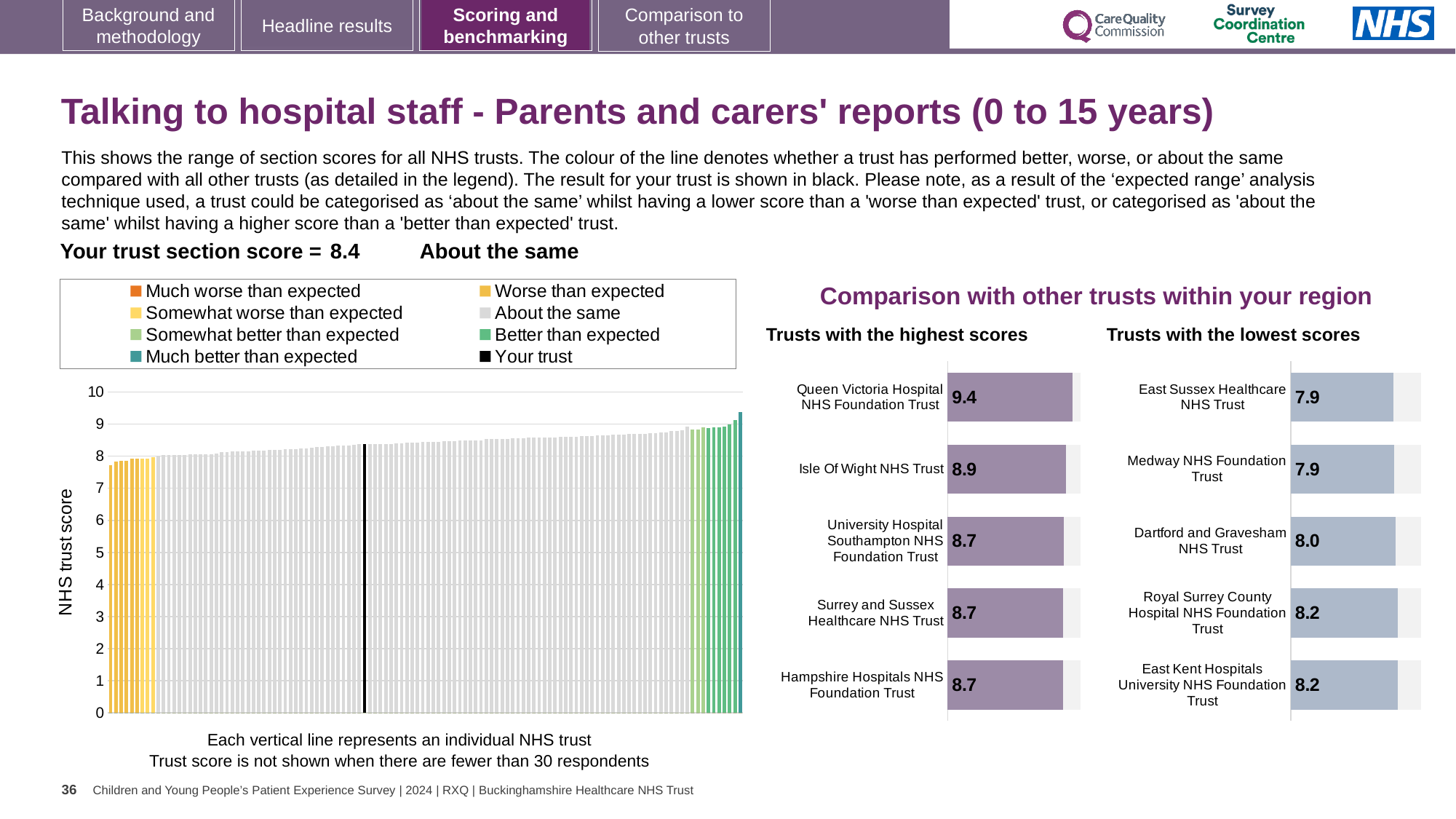
In the 'Trusts with the lowest scores' chart, what is the score for East Sussex Healthcare NHS Trust? 7.9 In the 'Trusts with the highest scores' chart, what is the score for Queen Victoria Hospital NHS Foundation Trust? 9.4 In the 'Trusts with the highest scores' chart, what is the difference between the scores of Queen Victoria Hospital NHS Foundation Trust and Isle Of Wight NHS Trust? 0.5 In the 'Trusts with the lowest scores' chart, what is the score for Dartford and Gravesham NHS Trust? 8.0 In the 'NHS trust score' chart on the left, do the values rise or fall from left to right? Rise In the 'NHS trust score' chart on the left, is the value of the rightmost (tallest) bar greater or less than 9? greater In the 'Trusts with the highest scores' chart, which trust has the highest score? Queen Victoria Hospital NHS Foundation Trust In the 'Trusts with the highest scores' chart, what is the score for Isle Of Wight NHS Trust? 8.9 How many trusts are shown in the 'Trusts with the highest scores' chart? 5 Comparing the 'Trusts with the lowest scores' chart values, which is larger: Royal Surrey County Hospital NHS Foundation Trust or Medway NHS Foundation Trust? Royal Surrey County Hospital NHS Foundation Trust What kind of chart is the 'NHS trust score' chart on the left of the slide? Bar chart How many entries does the legend of the 'NHS trust score' chart on the left list? 8